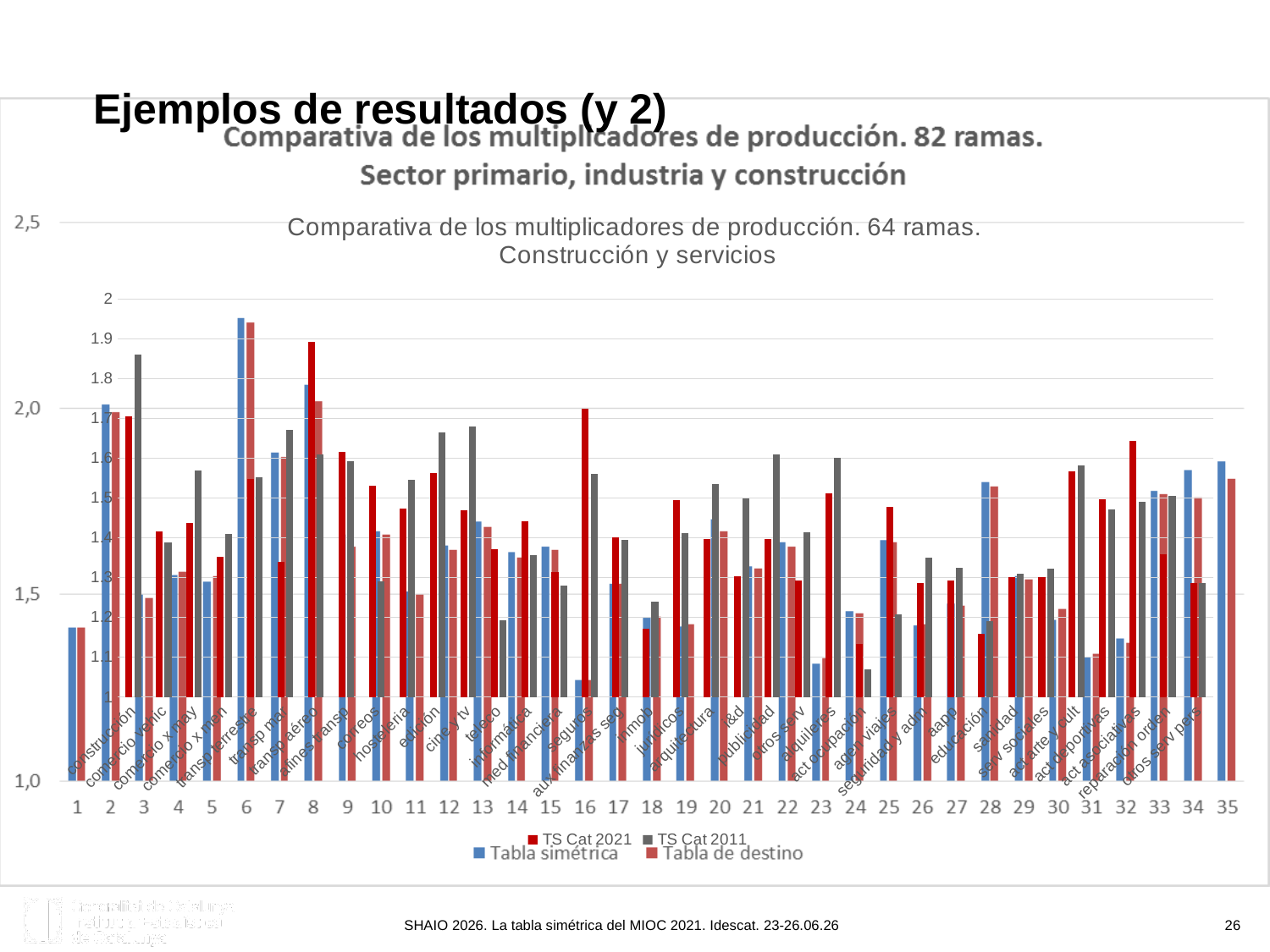
In the chart titled 'Comparativa de los multiplicadores de producción. 64 ramas. Construcción y servicios', is the TS Cat 2021 value for 'seguros' greater or less than 1.5? greater In the chart titled 'Comparativa de los multiplicadores de producción. 64 ramas. Construcción y servicios', how many series does the legend list? 2 In the chart titled 'Comparativa de los multiplicadores de producción. 64 ramas. Construcción y servicios', which series has the larger value for 'construcción', TS Cat 2021 or TS Cat 2011? TS Cat 2011 In the chart titled 'Comparativa de los multiplicadores de producción. 82 ramas. Sector primario, industria y construcción', how many numbered categories are on the x axis? 35 In the chart titled 'Comparativa de los multiplicadores de producción. 64 ramas. Construcción y servicios', is the TS Cat 2021 value for 'transp aéreo' greater or less than 1.8? greater What kind of chart is used on this slide? Bar chart In the chart titled 'Comparativa de los multiplicadores de producción. 64 ramas. Construcción y servicios', is the TS Cat 2011 value for 'construcción' greater or less than 1.8? greater In the chart titled 'Comparativa de los multiplicadores de producción. 64 ramas. Construcción y servicios', which category has the highest TS Cat 2021 value? transp aéreo In the chart titled 'Comparativa de los multiplicadores de producción. 82 ramas. Sector primario, industria y construcción', what are the two legend entries? Tabla simétrica and Tabla de destino In the chart titled 'Comparativa de los multiplicadores de producción. 64 ramas. Construcción y servicios', what are the two legend entries? TS Cat 2021 and TS Cat 2011 In the chart titled 'Comparativa de los multiplicadores de producción. 64 ramas. Construcción y servicios', which series has the larger value for 'seguros', TS Cat 2021 or TS Cat 2011? TS Cat 2021